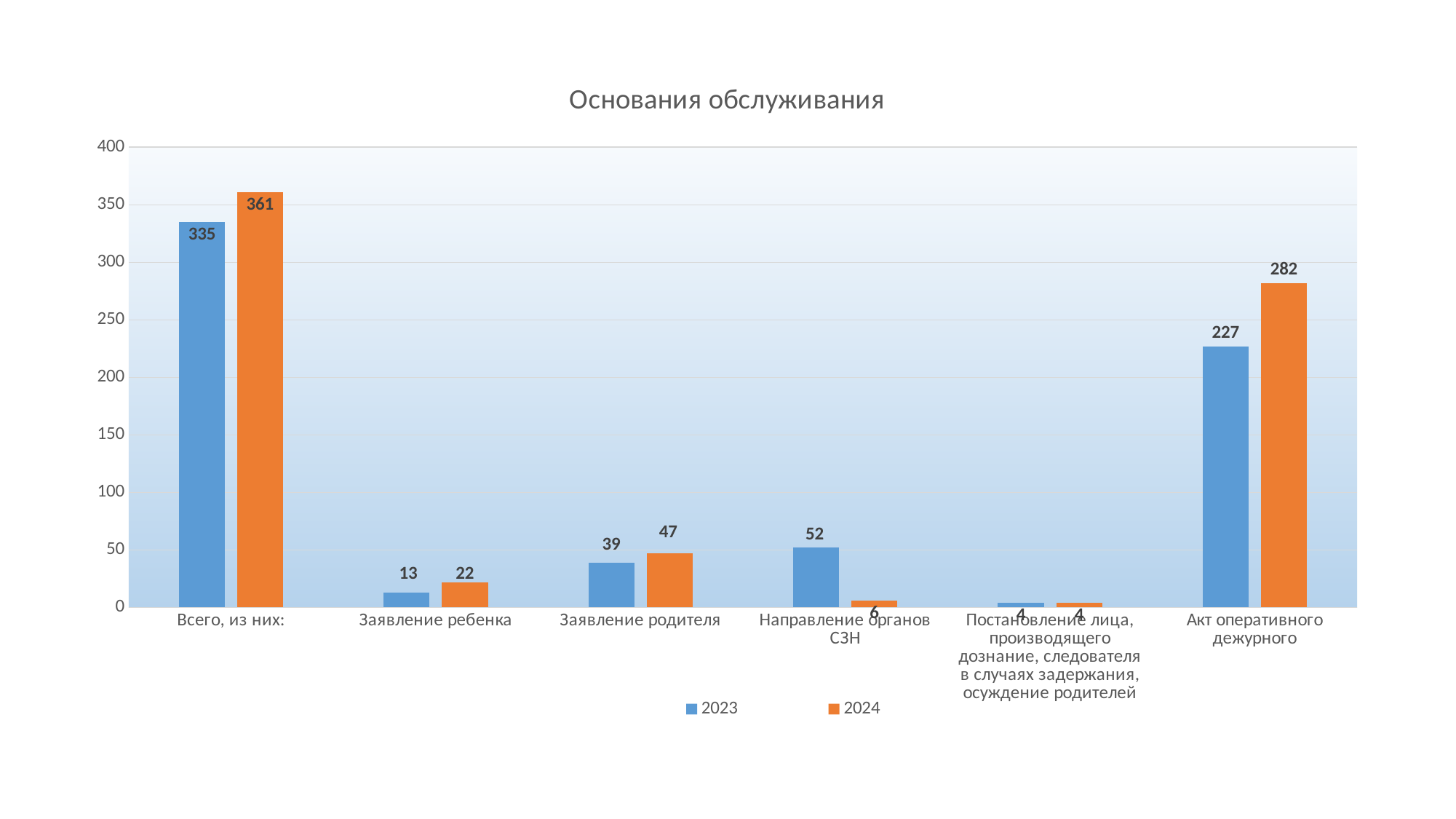
What is the value for 2023 for "Заявление родителя"? 39 How many categories are shown on the x axis? 6 What is the value for 2024 for "Всего, из них:"? 361 What is the difference between the 2024 and 2023 values for "Акт оперативного дежурного"? 55 Which category has the lowest value for 2023? Постановление лица, производящего дознание, следователя в случаях задержания, осуждение родителей Which is larger for "Направление органов СЗН": the 2023 value or the 2024 value? 2023 What kind of chart is shown on the slide? Bar chart What is the value for 2023 for "Акт оперативного дежурного"? 227 How many series does the legend list? 2 What is the value for 2024 for "Направление органов СЗН"? 6 Excluding the "Всего, из них:" total, which category has the highest value for 2024? Акт оперативного дежурного What is the title of the chart? Основания обслуживания